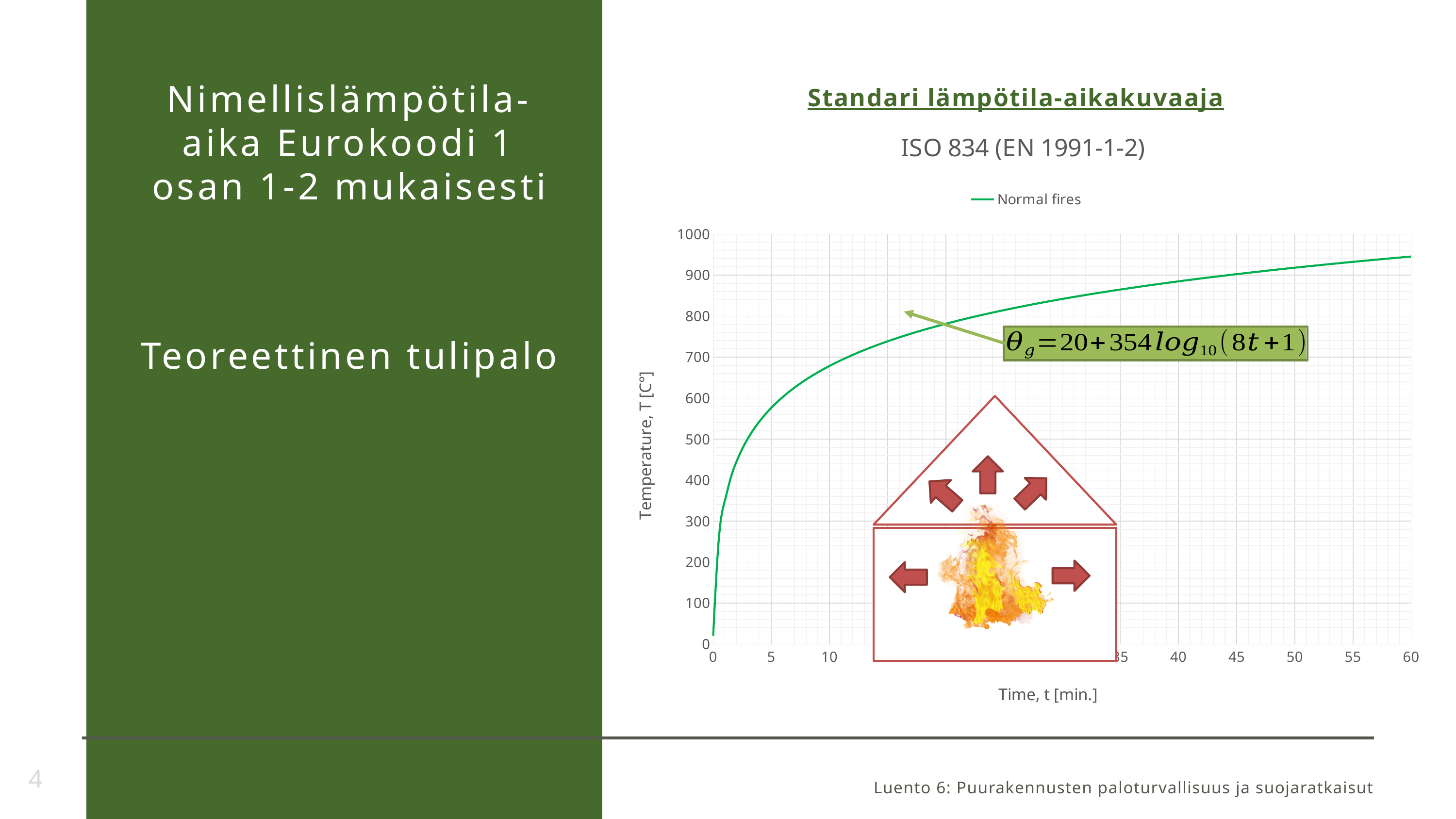
At which time shown on the x axis is the temperature lowest? 0 How many series does the legend of the chart list? 1 What is the name of the series shown in the chart legend? Normal fires Is the temperature at 30 minutes greater or less than 900? less What is the title of the chart? ISO 834 (EN 1991-1-2) Is the temperature at 10 minutes greater or less than 800? less Is the temperature at 50 minutes greater or less than 900? greater Does the temperature rise or fall as time increases along the x axis? rise What kind of chart is shown on the slide? line chart At which time shown on the x axis is the temperature highest? 60